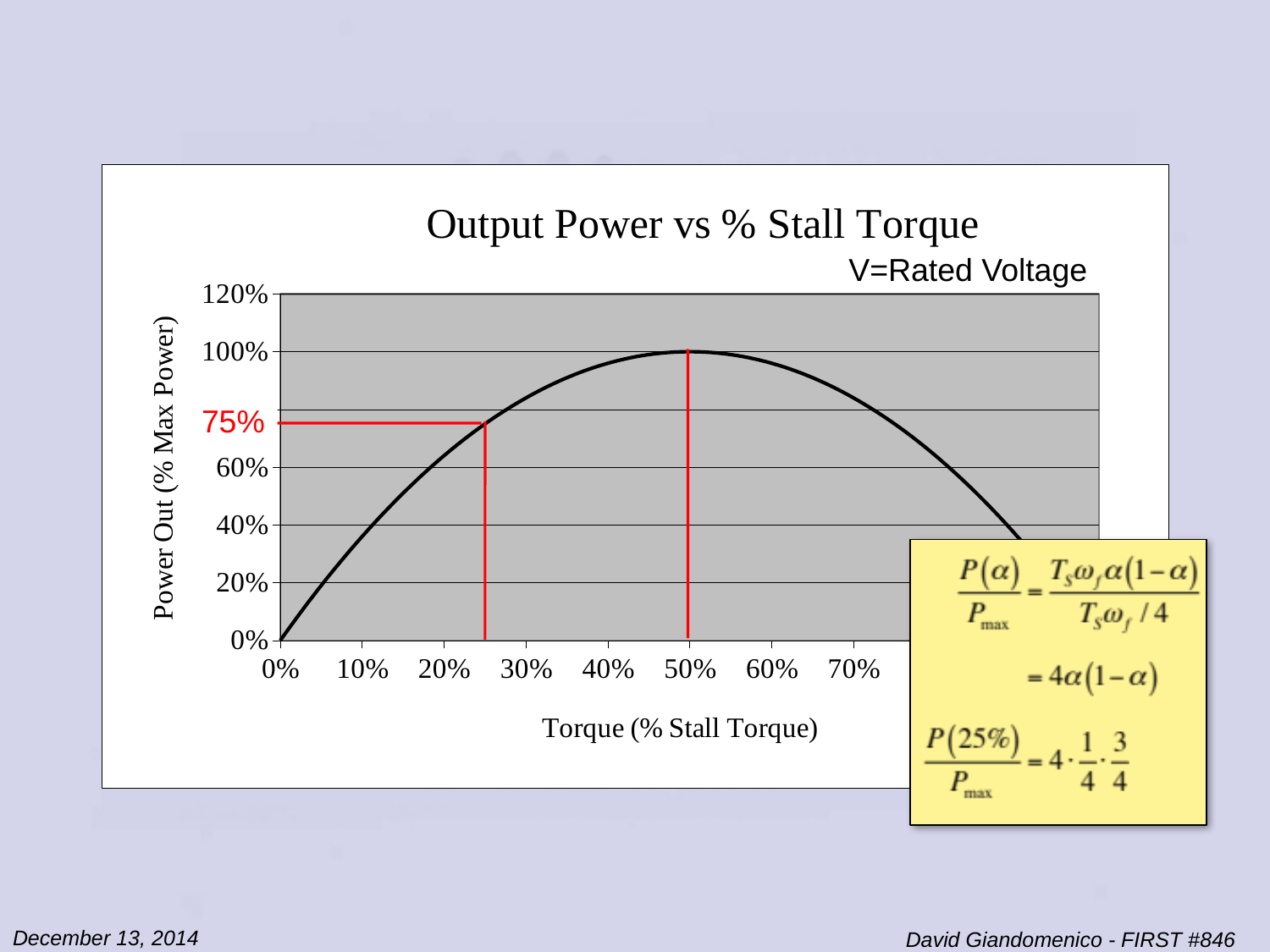
At what torque (% Stall Torque) does the curve reach its maximum power out? 50% Is the Power Out at 10% stall torque greater or less than 40%? less Is the Power Out at 70% stall torque greater or less than 60%? greater What is the label of the x axis of the chart? Torque (% Stall Torque) Does the curve rise or fall as torque increases from 0% to 50%? rise What kind of chart is shown on the slide? line chart What is the Power Out (% Max Power) at 0% stall torque? 0% Does the curve rise or fall as torque increases from 50% to 70%? fall Is the Power Out at 10% stall torque greater or less than 20%? greater What is the Power Out (% Max Power) at 25% stall torque, as marked by the red lines? 75% What is the title of the chart? Output Power vs % Stall Torque What is the highest value of Power Out reached by the curve? 100%